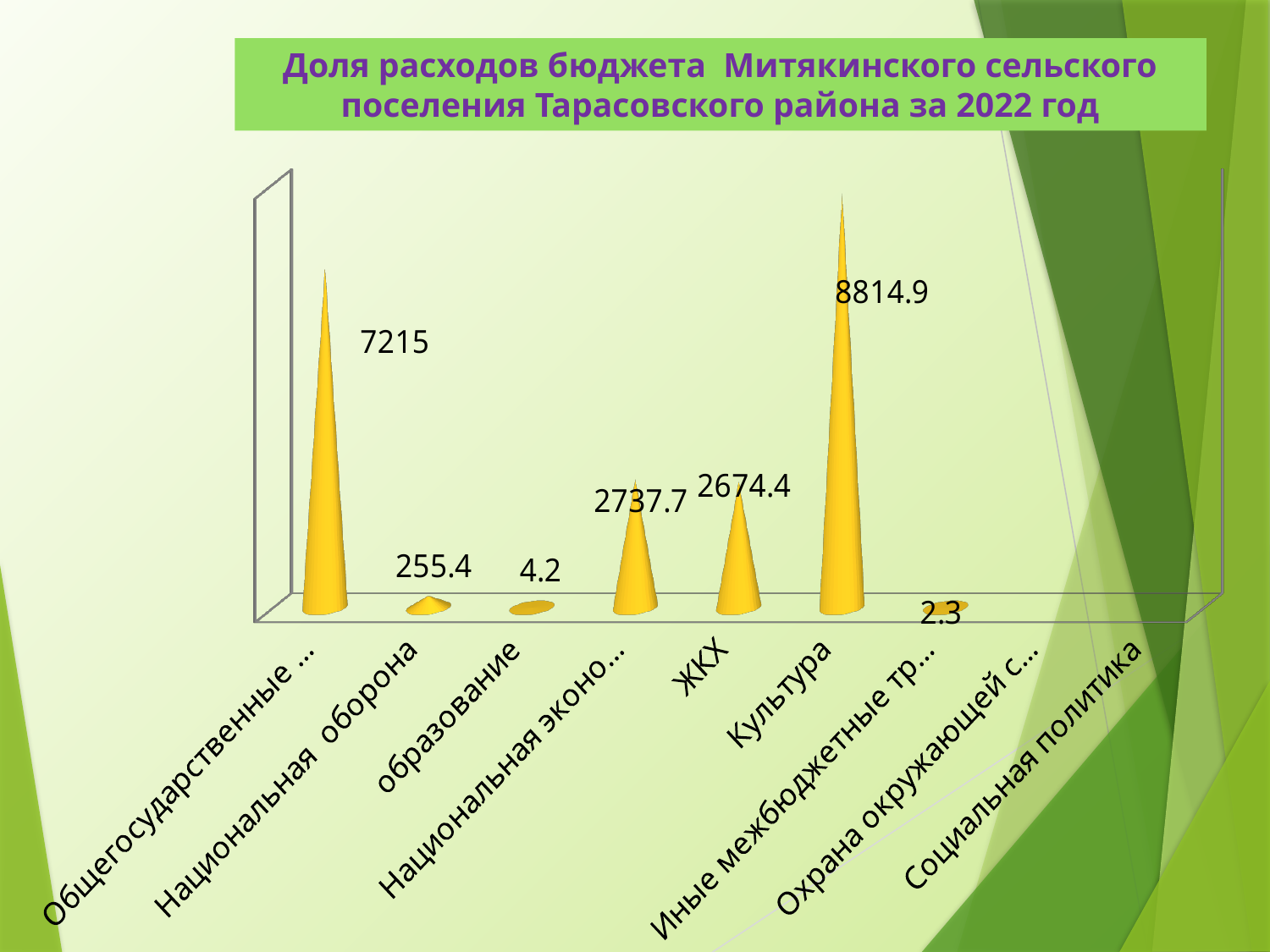
What is the difference between the values for Национальная эконо... and ЖКХ? 63.3 What year does the chart title say the budget expenditure shares are for? 2022 What is the value for ЖКХ? 2674.4 What kind of chart is shown on the slide? Bar chart What is the value for Культура? 8814.9 Which category has the highest value? Культура Which is larger, the value for Общегосударственные ... or the value for Культура? Культура What is the difference between the values for Культура and Общегосударственные ...? 1599.9 What is the value for образование? 4.2 What is the value for Национальная оборона? 255.4 What is the value labelled for the category Иные межбюджетные тр...? 2.3 How many categories are shown on the x axis? 9